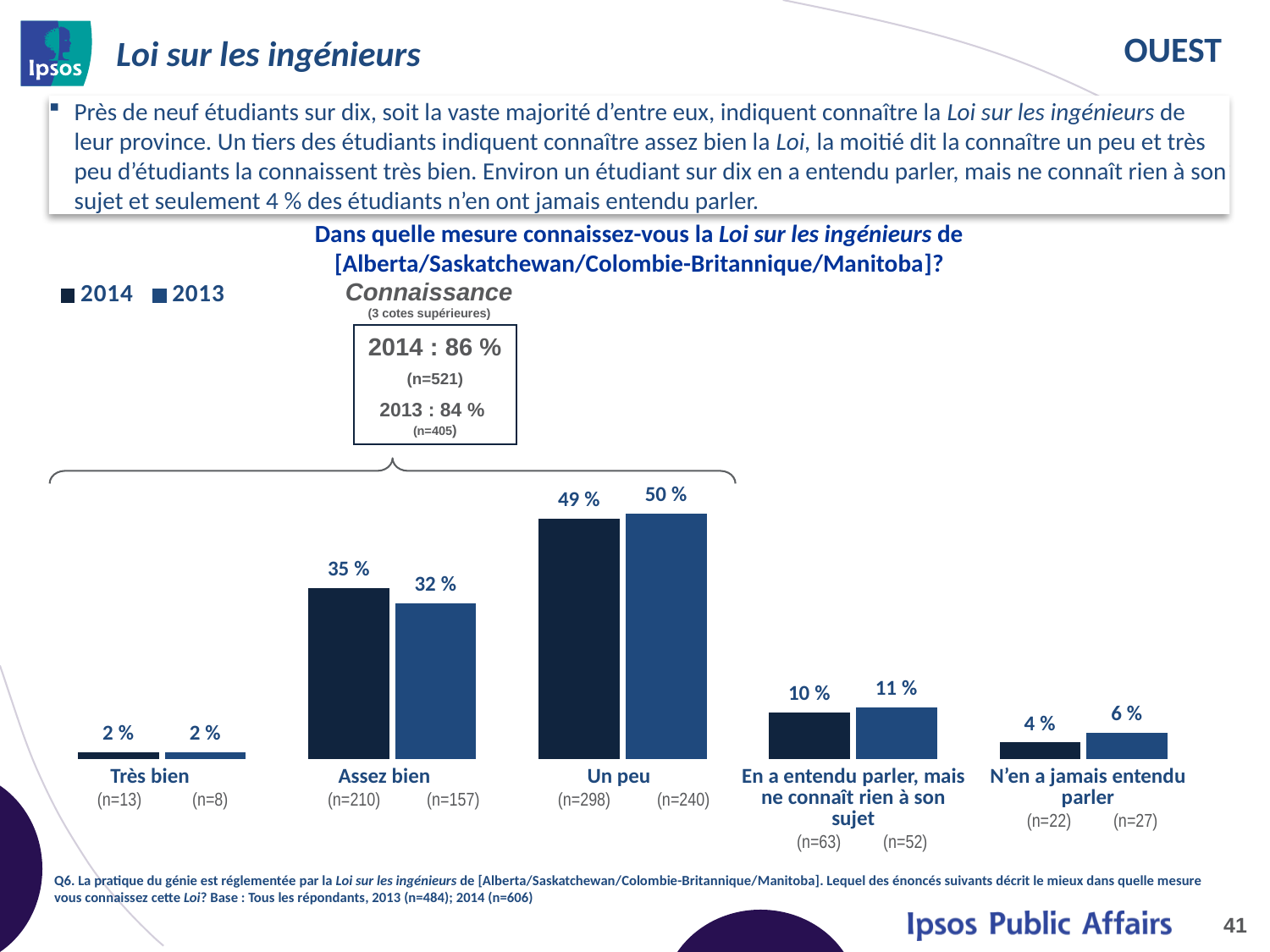
What kind of chart is shown on the slide? Bar chart Which category has the lowest 2013 value? Très bien What is the 2013 value for "Un peu"? 50 % What is the difference between the 2014 and 2013 values for "Assez bien"? 3 % Which category has the highest 2014 value? Un peu How many categories are shown on the x axis of the chart? 5 What is the 2014 value for "En a entendu parler, mais ne connaît rien à son sujet"? 10 % What is the 2014 "Connaissance" (3 cotes supérieures) percentage shown in the box above the chart? 86 % Which is larger for "N'en a jamais entendu parler": the 2014 value or the 2013 value? 2013 What is the 2013 value for "N'en a jamais entendu parler"? 6 % How many series does the legend list? 2 What is the 2014 value for "Assez bien"? 35 %